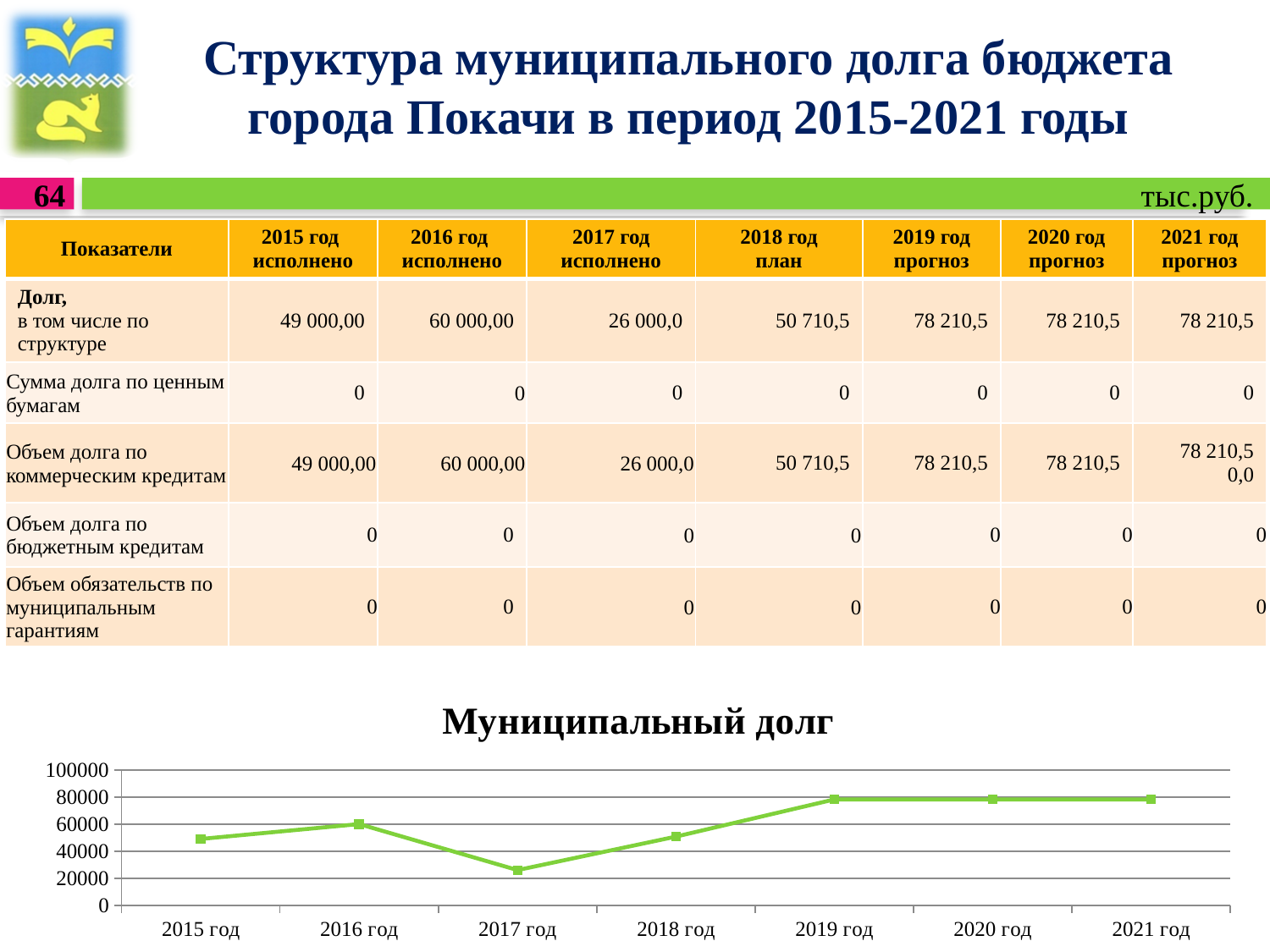
In the "Муниципальный долг" chart, does the line rise or fall from 2017 год to 2019 год? rise In the "Муниципальный долг" chart, which is larger, the value for 2017 год or 2018 год? 2018 год What kind of chart is shown under the title "Муниципальный долг"? line chart In the "Муниципальный долг" chart, is the value for 2015 год greater or less than 60000? less What is the highest tick value shown on the y axis of the "Муниципальный долг" chart? 100000 In the "Муниципальный долг" chart, which is larger, the value for 2015 год or 2016 год? 2016 год Which year has the lowest value in the "Муниципальный долг" chart? 2017 год In the "Муниципальный долг" chart, is the value for 2016 год greater or less than 40000? greater How many years are plotted on the x axis of the "Муниципальный долг" chart? 7 In the "Муниципальный долг" chart, is the value for 2019 год greater or less than 60000? greater What is the title of the chart at the bottom of the slide? Муниципальный долг